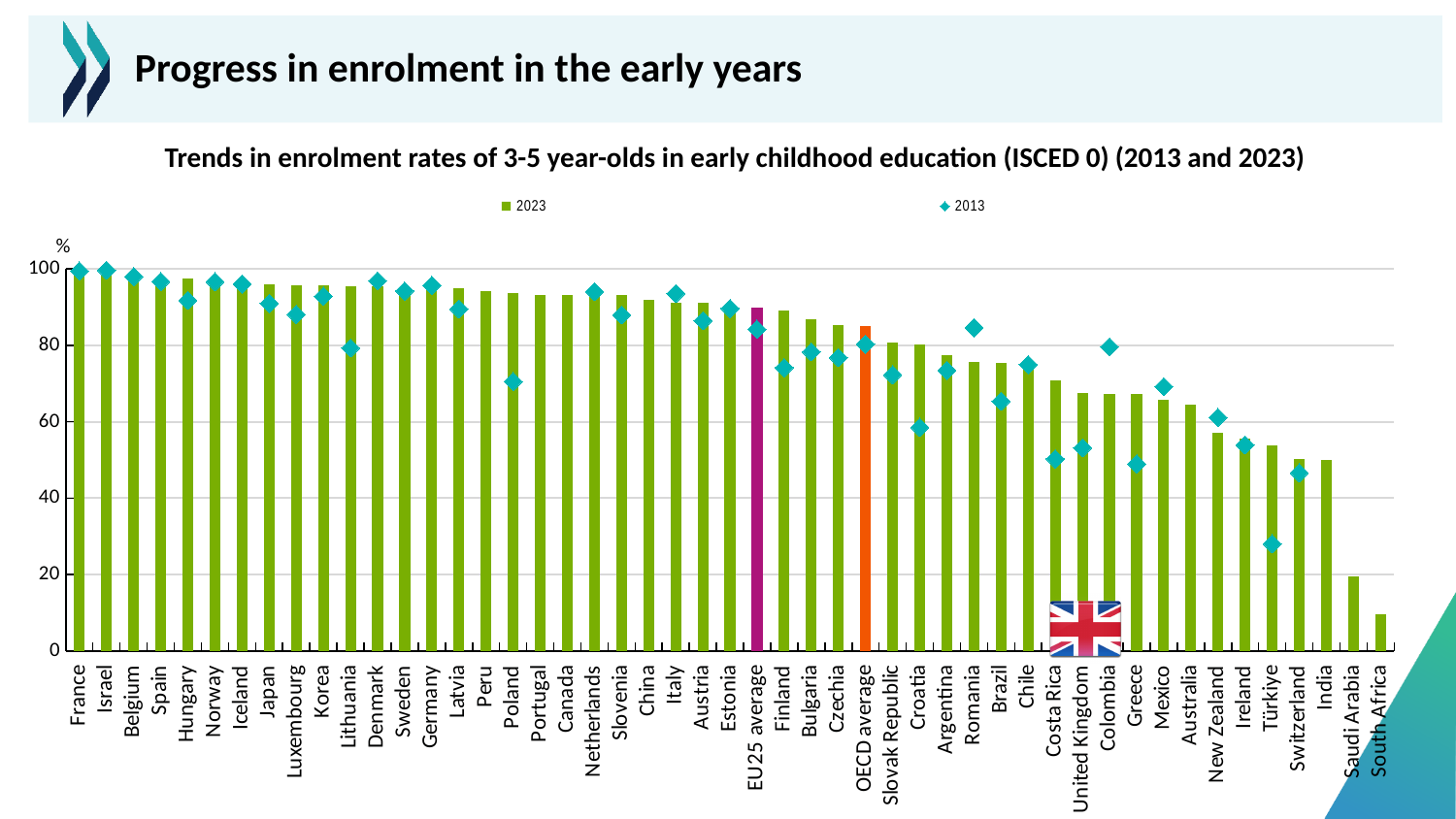
How many series does the legend list? 2 Which has the higher 2023 enrolment rate, Finland or Mexico? Finland Which category's bar is coloured orange instead of green? OECD average Which two years are compared in the chart? 2013 and 2023 Is the 2013 value for Türkiye greater or less than 40? less Do the 2023 values rise or fall moving from left to right along the x axis? fall Is the 2013 value for Poland greater or less than 60? greater Is the 2013 value for Romania greater or less than 80? greater Which country has the lowest 2023 enrolment rate? South Africa What kind of chart is shown on the slide? bar chart